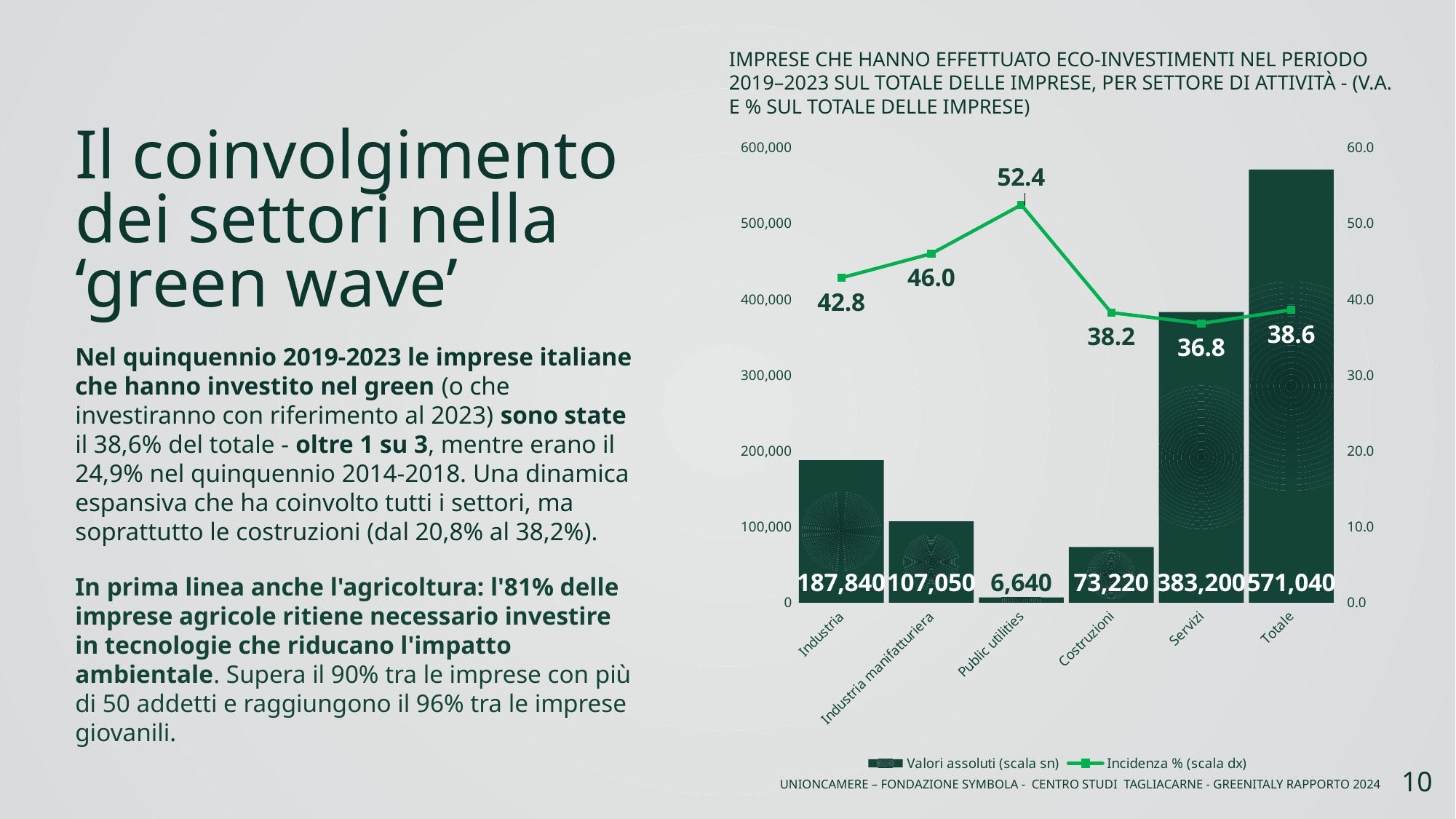
What is the absolute value (Valori assoluti) for Costruzioni? 73,220 Which category has the highest Incidenza % value? Public utilities What is the difference between the absolute values for Industria and Industria manifatturiera? 80,790 Which has a higher Incidenza % value, Industria or Industria manifatturiera? Industria manifatturiera How many categories are shown on the x axis of the chart? 6 What are the two series listed in the chart legend? Valori assoluti (scala sn) and Incidenza % (scala dx) What is the absolute value (Valori assoluti) for Servizi? 383,200 How many series does the chart legend list? 2 What is the Incidenza % value for Public utilities? 52.4 Which category has the lowest Incidenza % value? Servizi What is the difference between the Incidenza % values for Public utilities and Costruzioni? 14.2 Excluding Totale, which sector has the lowest absolute value (Valori assoluti)? Public utilities